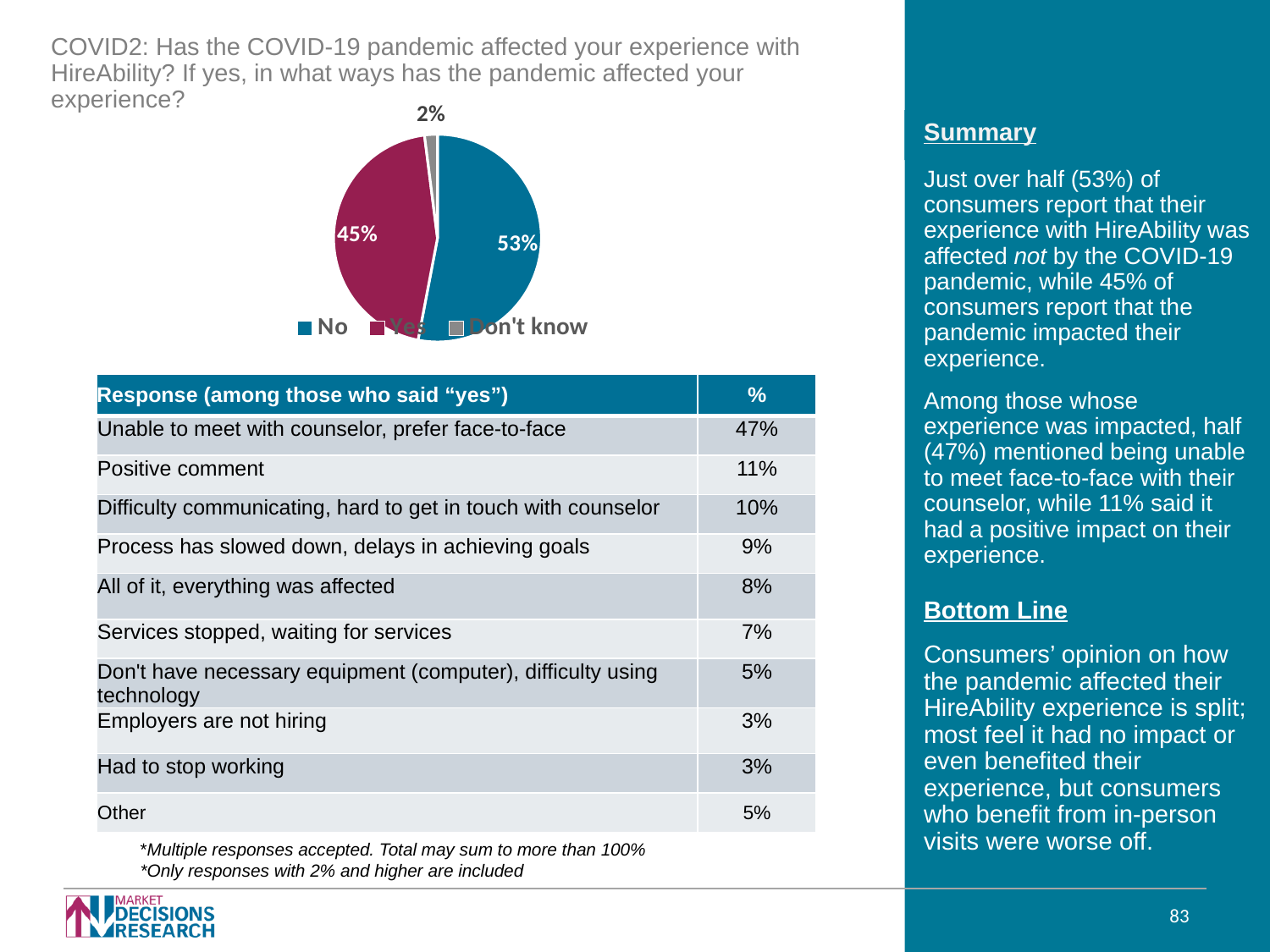
What is the difference in percentage points between the "No" and "Yes" slices of the pie chart? 8 What colour is the "Yes" slice in the pie chart? dark red What kind of chart is shown on the slide? pie chart Which response has the largest slice in the pie chart? No Which response has the smallest slice in the pie chart? Don't know Which slice of the pie chart is larger, "Yes" or "Don't know"? Yes How many entries does the pie chart legend list? 3 What share of the pie chart is labelled "Yes"? 45% What colour is the "No" slice in the pie chart? blue What share of the pie chart is labelled "Don't know"? 2% How many slices does the pie chart have? 3 What share of the pie chart is labelled "No"? 53%